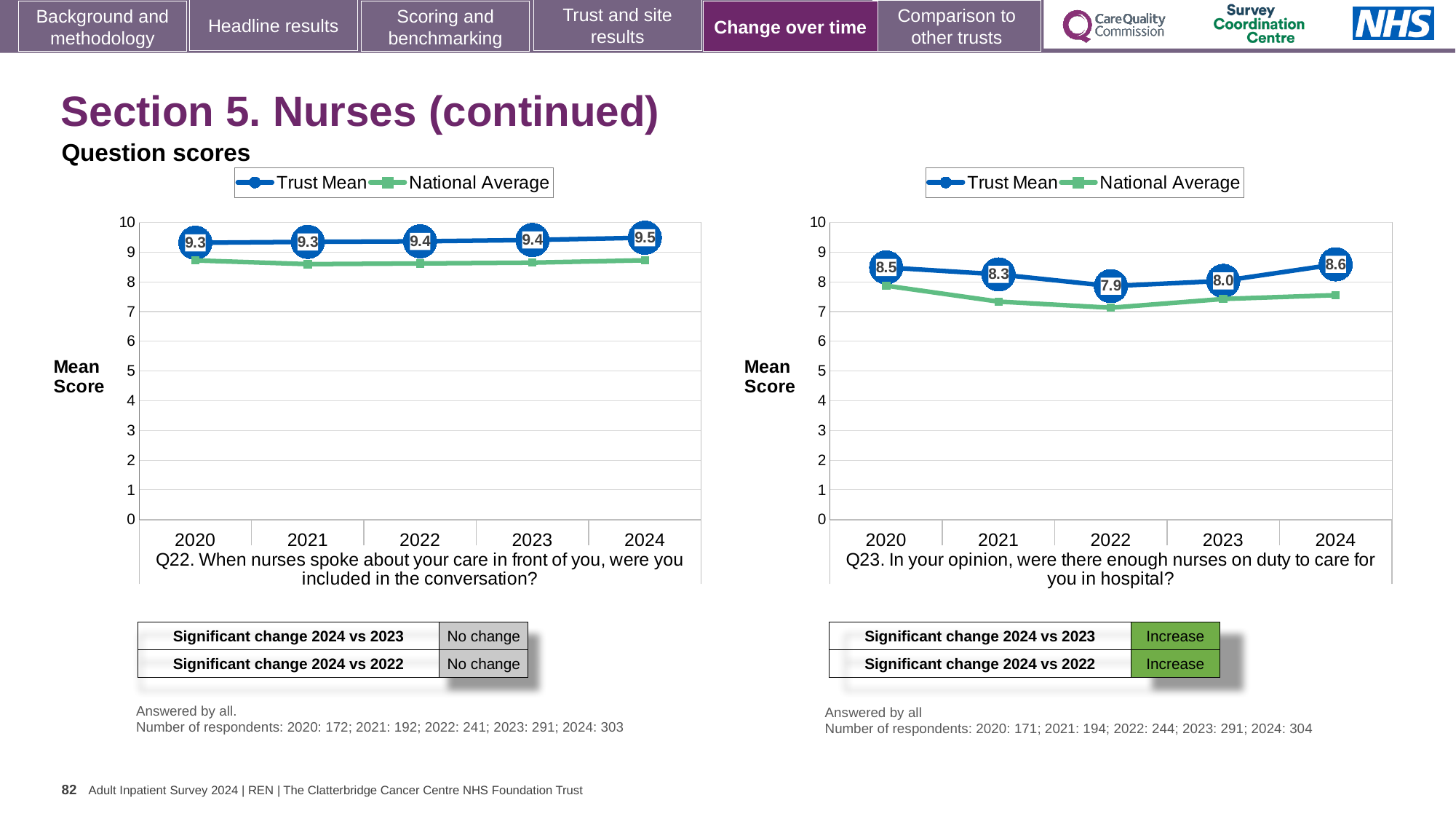
In the Q22 chart on the left, is the National Average value for 2021 greater or less than 9? less In the Q23 chart on the right, what is the Trust Mean score for 2022? 7.9 In the Q23 chart on the right, is the Trust Mean score for 2020 or 2021 larger? 2020 How many series does the legend of the Q23 chart on the right list? 2 In the Q22 chart on the left, what is the Trust Mean score for 2024? 9.5 In the Q23 chart on the right, is the National Average value for 2022 greater or less than 8? less How many years are plotted on the x axis of the Q22 chart on the left? 5 What kind of chart is the Q22 chart on the left? Line chart In the Q23 chart on the right, what is the difference between the Trust Mean scores for 2024 and 2022? 0.7 In the Q22 chart on the left, what is the difference between the Trust Mean scores for 2024 and 2020? 0.2 In the Q23 chart on the right, which year has the highest Trust Mean score? 2024 In the Q23 chart on the right, which year has the lowest Trust Mean score? 2022